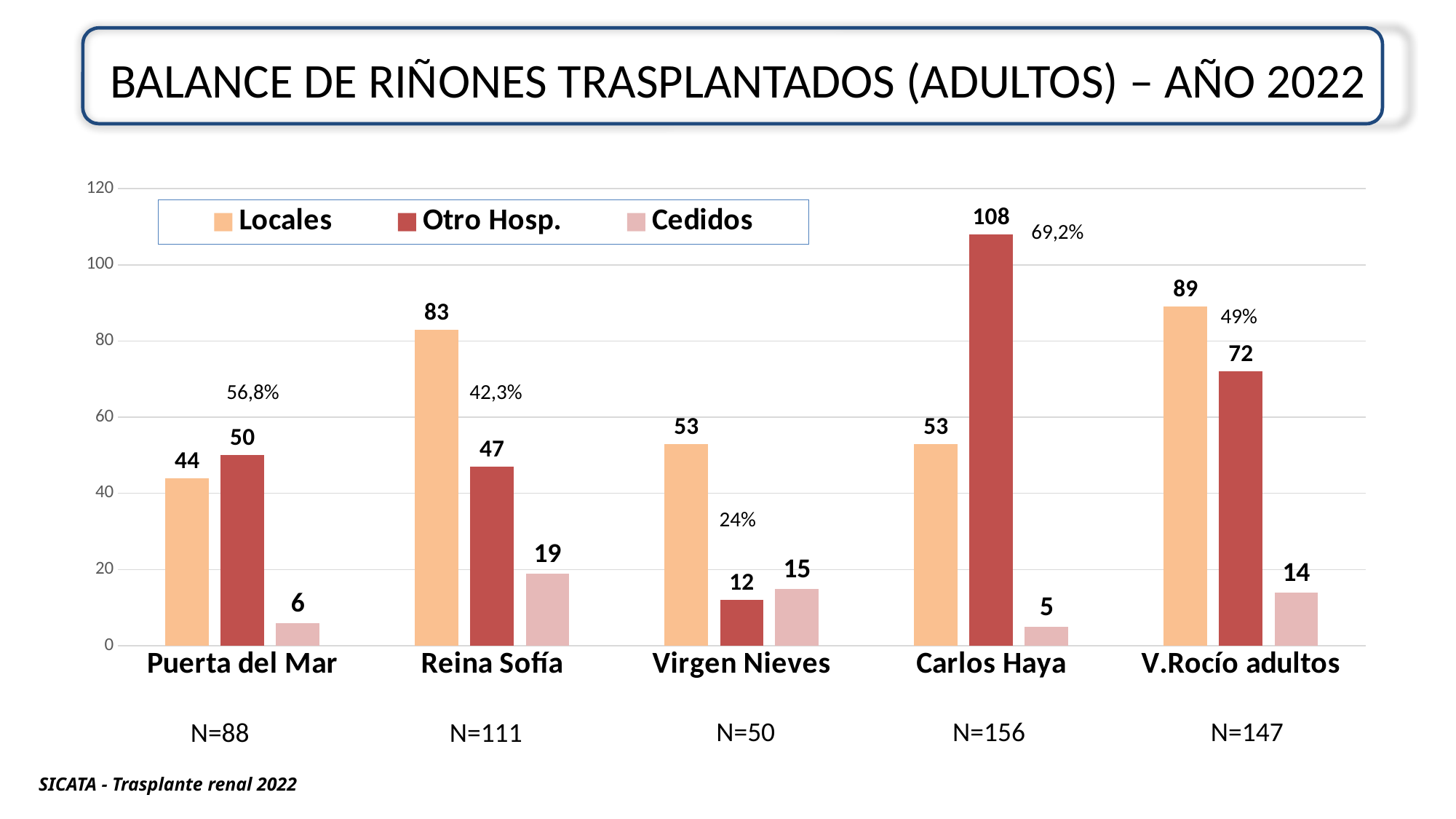
How many series does the legend list? 3 Which hospital has the lowest Cedidos value? Carlos Haya What is the Locales value for Reina Sofía? 83 What is the Cedidos value for Virgen Nieves? 15 What is the Otro Hosp. value for Carlos Haya? 108 What is the difference between the Locales and Otro Hosp. values for V.Rocío adultos? 17 What kind of chart is shown on the slide? Bar chart Which hospital has the highest Otro Hosp. value? Carlos Haya What percentage is printed next to the Carlos Haya bars? 69,2% How many hospitals are shown on the x axis? 5 What is the N value printed below Reina Sofía? N=111 Which is larger for Puerta del Mar, the Locales value or the Otro Hosp. value? Otro Hosp.